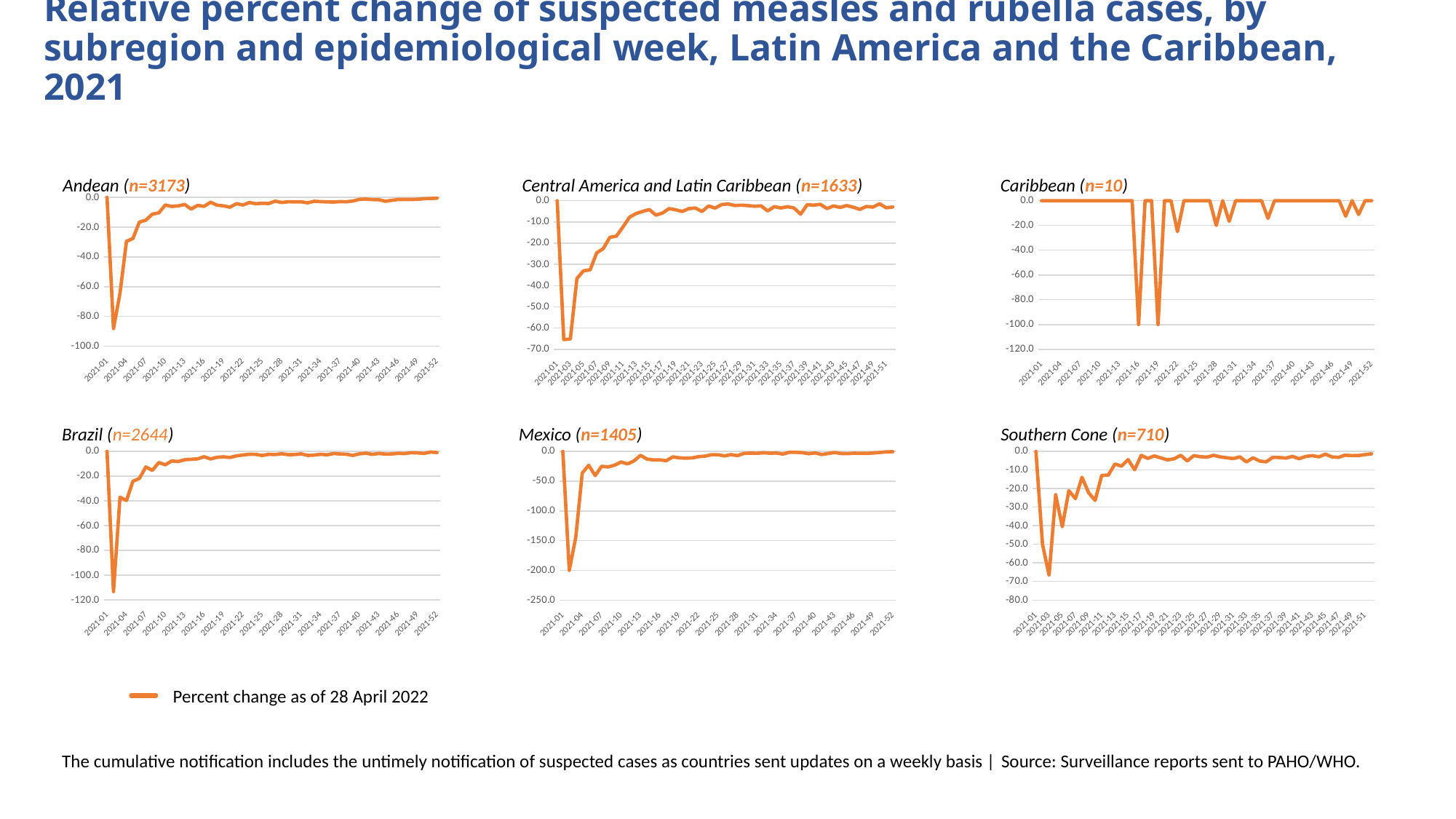
What does the legend entry at the bottom of the slide say? Percent change as of 28 April 2022 How many series does the legend list? 1 On the Mexico (n=1405) chart, is the lowest value greater or less than -150.0? less Which chart reaches a lower minimum value, Mexico (n=1405) or Andean (n=3173)? Mexico (n=1405) On the Central America and Latin Caribbean (n=1633) chart, is the lowest value greater or less than -60.0? less On the Southern Cone (n=710) chart, is the lowest value greater or less than -60.0? less What kind of chart is the Andean (n=3173) chart? line chart How many charts are shown on the slide? 6 On the Andean (n=3173) chart, do the values generally rise or fall from 2021-04 to 2021-52? rise What is the n value shown in the title of the Brazil chart? n=2644